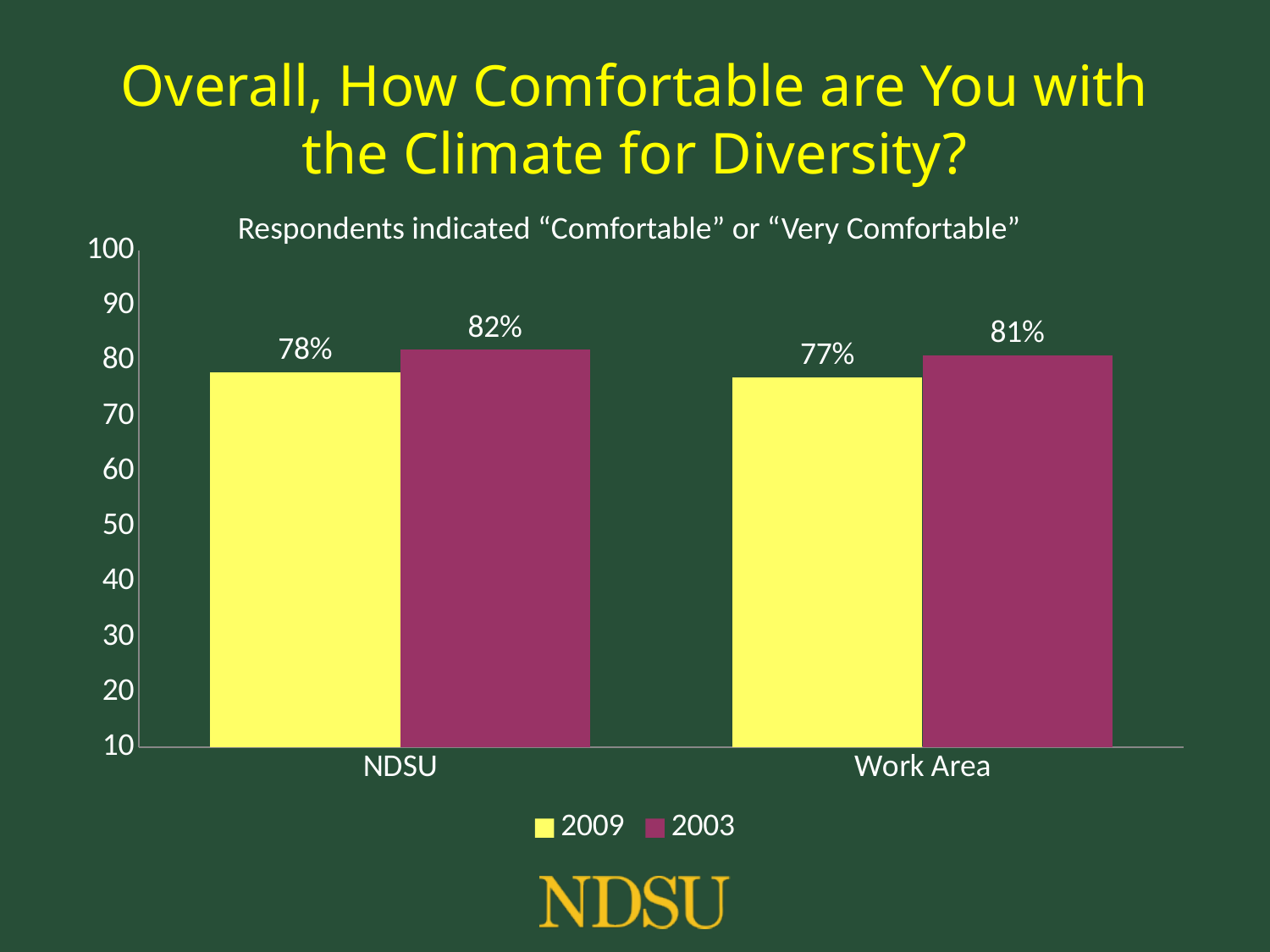
What kind of chart is shown on the slide? Bar chart What is the value for NDSU in 2003? 82% Which category has the highest value in the 2003 series? NDSU What is the value for NDSU in 2009? 78% Which is larger for Work Area, the 2009 value or the 2003 value? 2003 What is the value for Work Area in 2009? 77% What is the value for Work Area in 2003? 81% Which category has the lowest value in the 2009 series? Work Area What is the difference between the 2003 and 2009 values for NDSU? 4% What is the difference between the 2003 and 2009 values for Work Area? 4% How many categories are shown on the x axis? 2 How many series does the legend list? 2